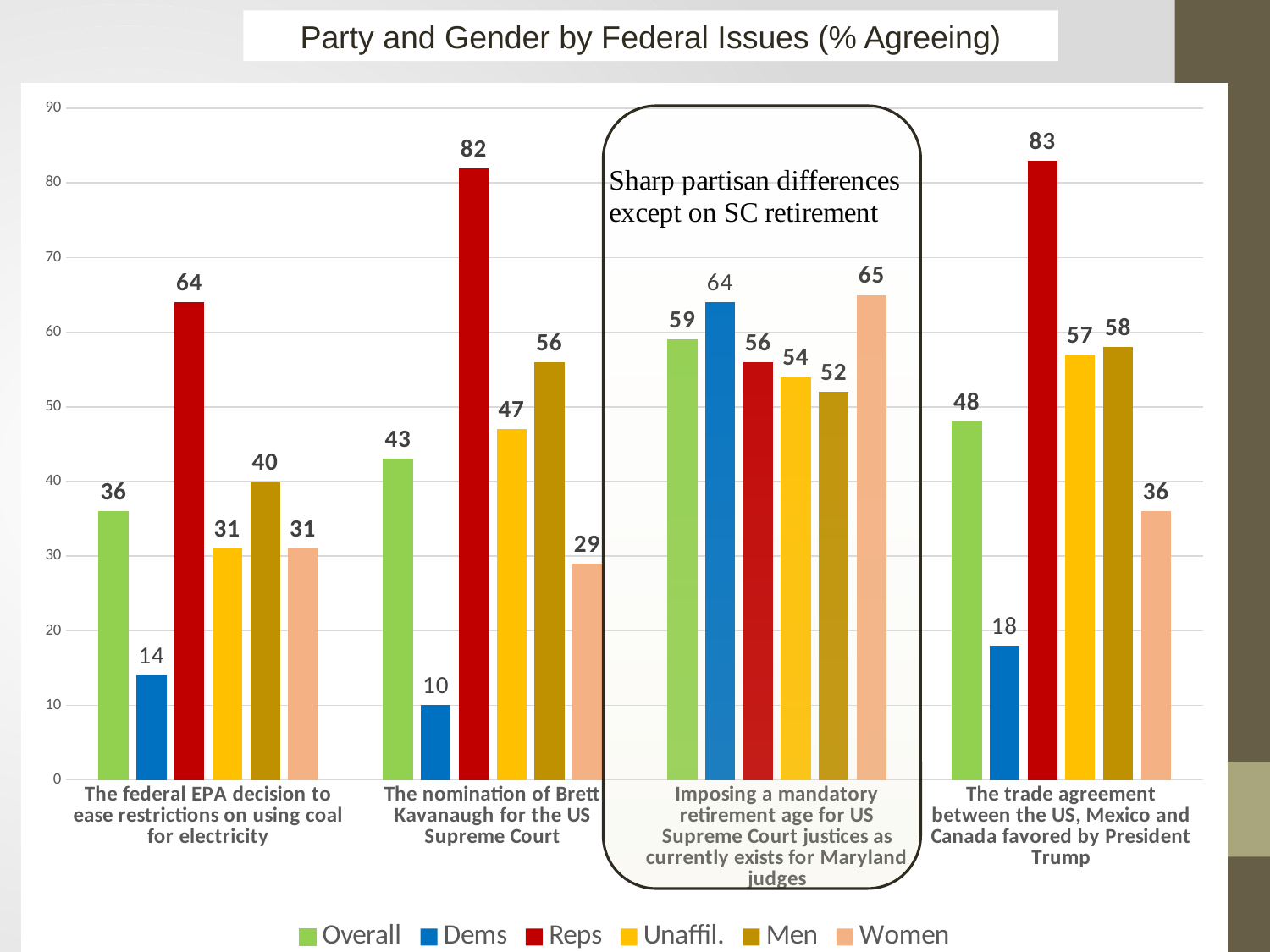
What is the Reps value for the nomination of Brett Kavanaugh for the US Supreme Court? 82 Which series has the lowest value for the nomination of Brett Kavanaugh for the US Supreme Court? Dems What kind of chart is shown on the slide? Bar chart Which series has the highest value for the trade agreement between the US, Mexico and Canada favored by President Trump? Reps What is the Overall value for the federal EPA decision to ease restrictions on using coal for electricity? 36 For imposing a mandatory retirement age for US Supreme Court justices, which is larger: the Dems value or the Reps value? Dems What is the Women value for imposing a mandatory retirement age for US Supreme Court justices? 65 What does the text in the rounded box on the chart say? Sharp partisan differences except on SC retirement How many issue categories are shown on the x axis? 4 What is the Dems value for the federal EPA decision to ease restrictions on using coal for electricity? 14 What is the difference between the Reps and Dems values for the trade agreement between the US, Mexico and Canada favored by President Trump? 65 How many series does the legend list? 6